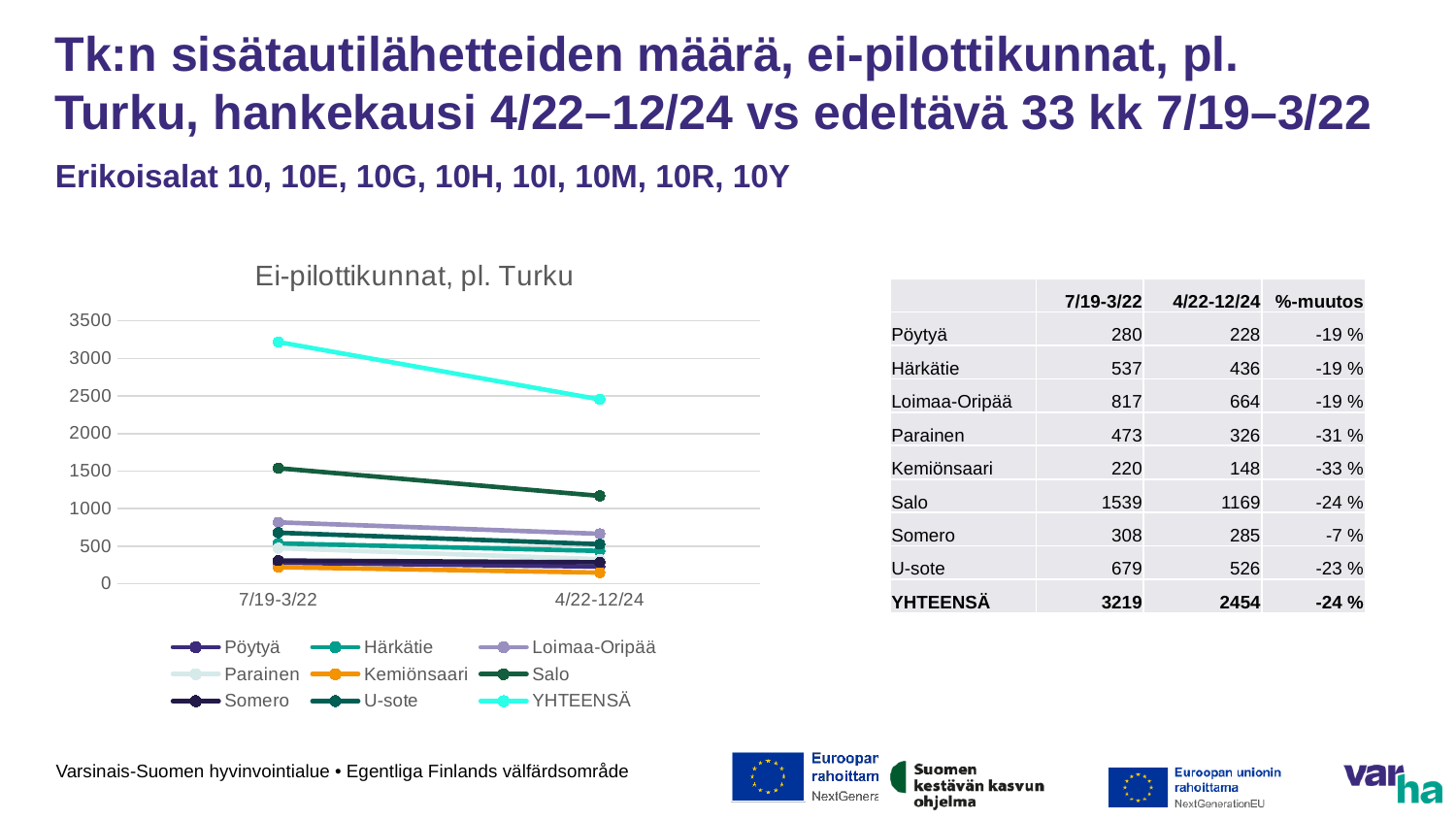
At 4/22-12/24, which is larger: Loimaa-Oripää or Härkätie? Loimaa-Oripää Is the value for YHTEENSÄ at 7/19-3/22 greater or less than 3000? greater How many points are there along the x axis of the chart? 2 Does the YHTEENSÄ line rise or fall from 7/19-3/22 to 4/22-12/24? fall Which series has the lowest value at 4/22-12/24? Kemiönsaari What is the difference between the YHTEENSÄ values at 7/19-3/22 and 4/22-12/24? 765 What type of chart is shown on the slide? line chart How many series does the chart legend list? 9 What is the value for Salo at 7/19-3/22? 1539 What is the title of the chart? Ei-pilottikunnat, pl. Turku Is the value for Salo at 4/22-12/24 greater or less than 1000? greater Which series has the highest value at 7/19-3/22? YHTEENSÄ